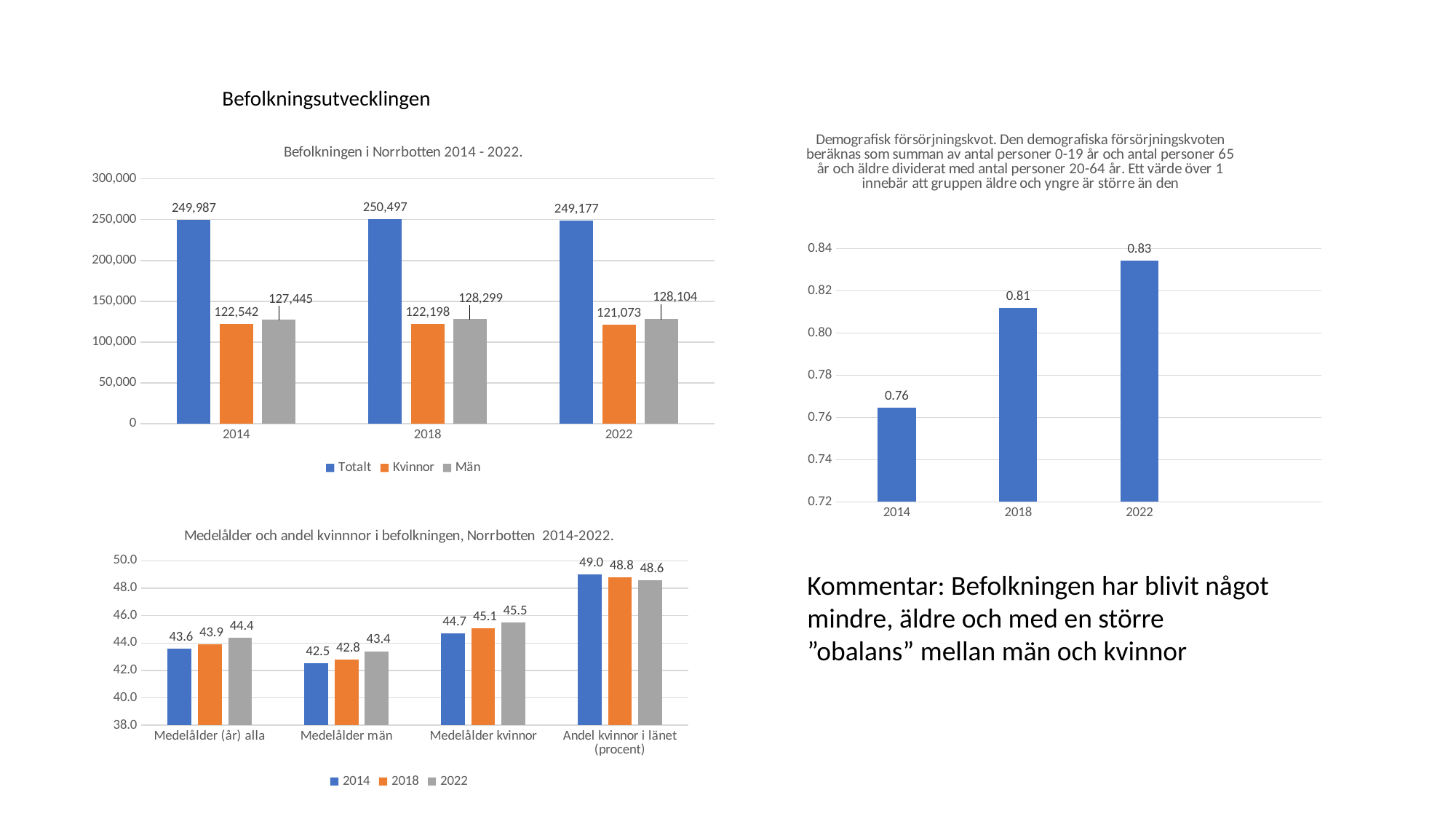
In the chart 'Medelålder och andel kvinnnor i befolkningen, Norrbotten 2014-2022.', does the value for Medelålder kvinnor rise or fall from 2014 to 2022? Rise In the chart on the right about Demografisk försörjningskvot, what is the value for 2014? 0.76 In the chart 'Befolkningen i Norrbotten 2014 - 2022.', what is the value for Kvinnor in 2022? 121,073 In the chart 'Befolkningen i Norrbotten 2014 - 2022.', what is the value for Totalt in 2018? 250,497 In the chart 'Medelålder och andel kvinnnor i befolkningen, Norrbotten 2014-2022.', what is the value for Medelålder män in 2022? 43.4 In the chart 'Befolkningen i Norrbotten 2014 - 2022.', which colour represents Kvinnor? Orange In the chart 'Befolkningen i Norrbotten 2014 - 2022.', which year has the highest Totalt value? 2018 In the chart 'Befolkningen i Norrbotten 2014 - 2022.', what is the difference between Män and Kvinnor in 2014? 4,903 In the chart 'Medelålder och andel kvinnnor i befolkningen, Norrbotten 2014-2022.', which is larger for Andel kvinnor i länet (procent): 2014 or 2022? 2014 What kind of chart is the chart on the right about Demografisk försörjningskvot? Bar chart In the chart 'Medelålder och andel kvinnnor i befolkningen, Norrbotten 2014-2022.', how many categories are shown on the x axis? 4 In the chart 'Befolkningen i Norrbotten 2014 - 2022.', how many series does the legend list? 3